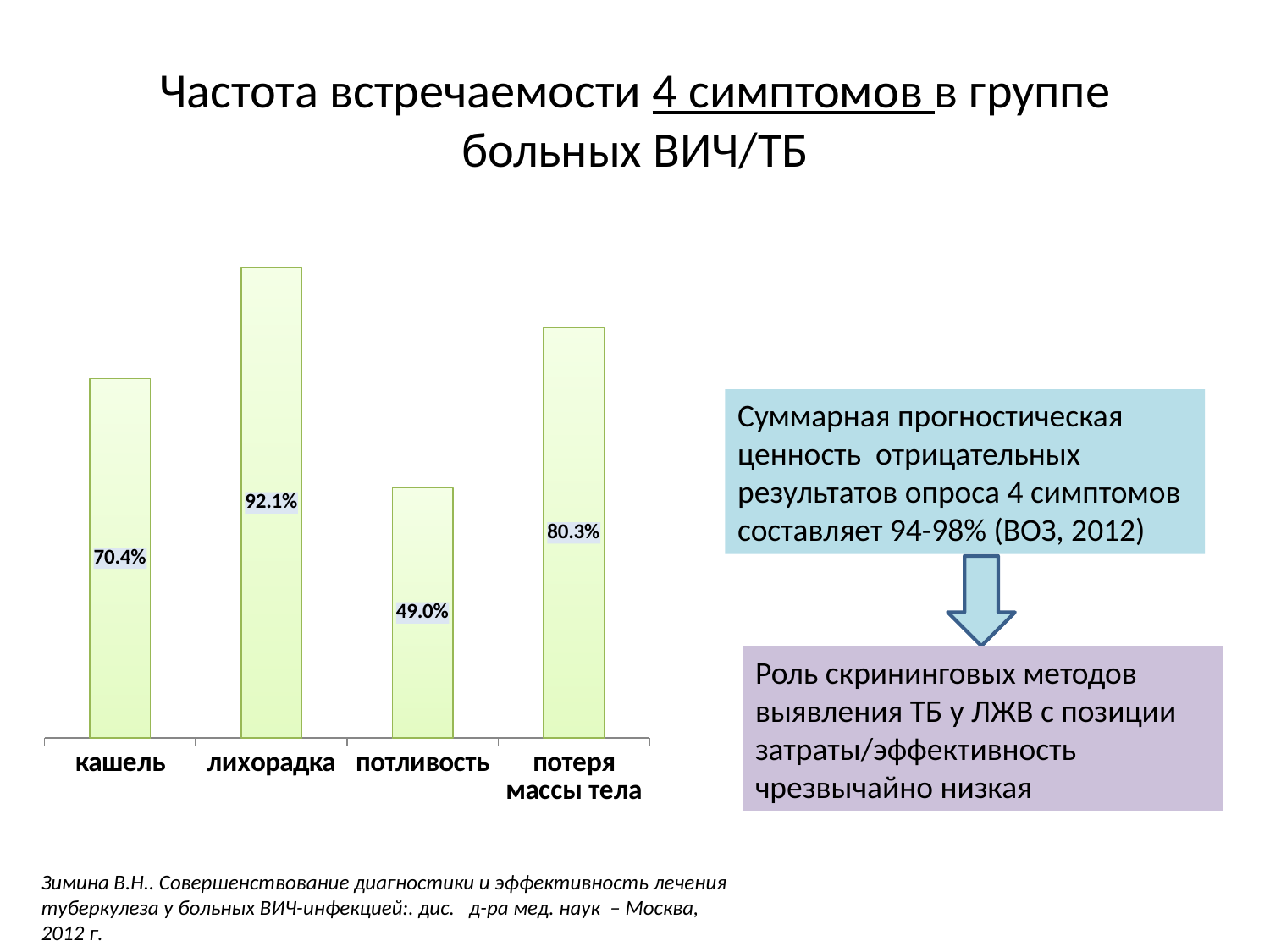
What is the difference between the values for лихорадка and потливость? 43.1% What is the value for лихорадка? 92.1% What is the value for кашель? 70.4% What kind of chart is shown on the slide? bar chart How many categories are shown in the chart? 4 What is the title of the slide containing the chart? Частота встречаемости 4 симптомов в группе больных ВИЧ/ТБ What is the value for потливость? 49.0% Which symptom has the highest frequency? лихорадка Which is larger, the value for кашель or the value for потеря массы тела? потеря массы тела What is the value for потеря массы тела? 80.3% Which symptom has the lowest frequency? потливость What is the difference between the values for потеря массы тела and кашель? 9.9%